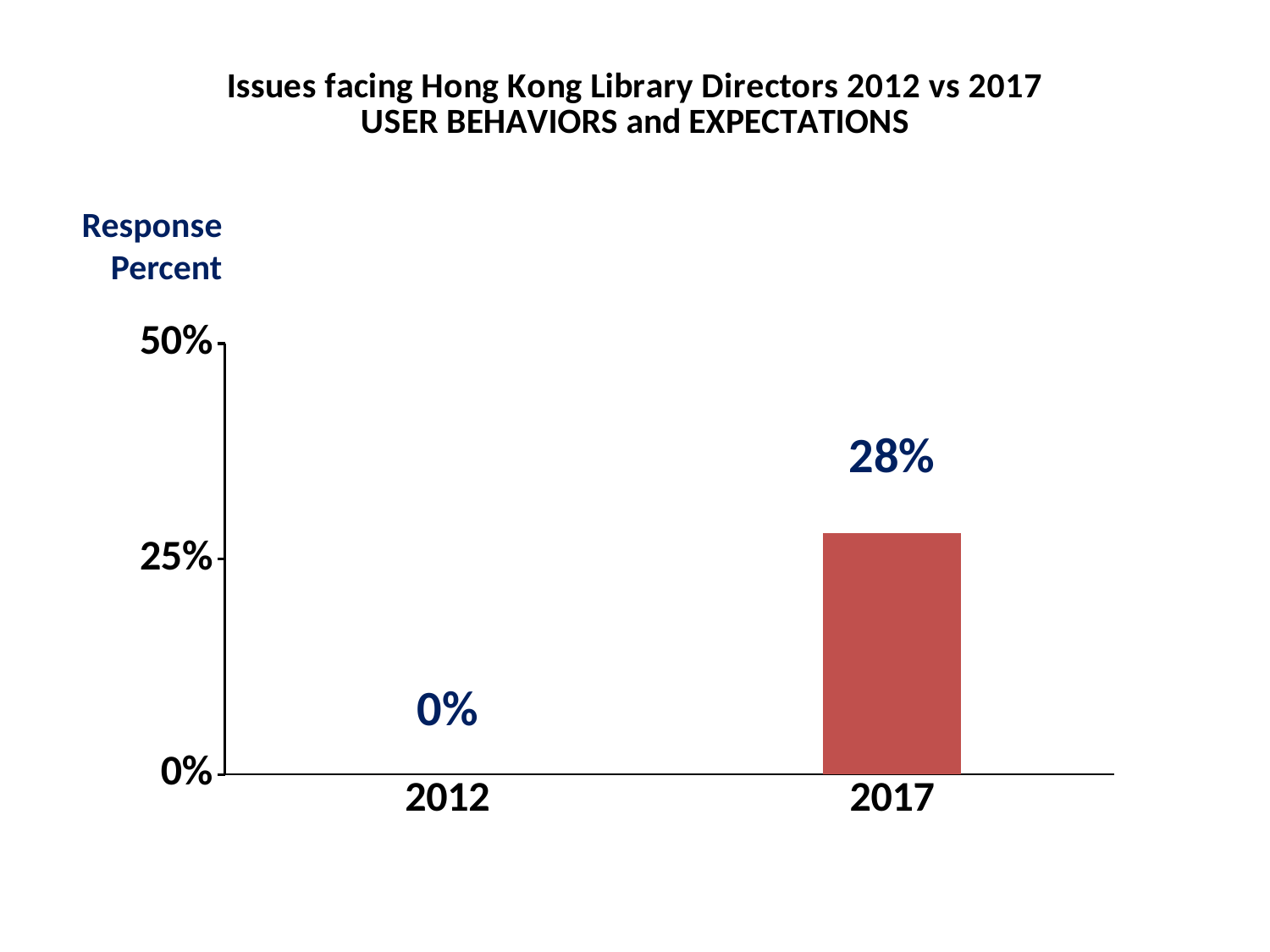
How many years are shown on the x axis? 2 What is the response percent for 2012? 0% What is the label of the y axis? Response Percent What is the response percent for 2017? 28% What is the difference in response percent between 2017 and 2012? 28% Is the response percent for 2017 greater or less than 50%? less Is the response percent for 2017 greater or less than 25%? greater Which year has the lower response percent? 2012 Does the response percent rise or fall from 2012 to 2017? Rise What kind of chart is shown on the slide? Bar chart Which year has the higher response percent? 2017 What is the highest value shown on the y axis? 50%